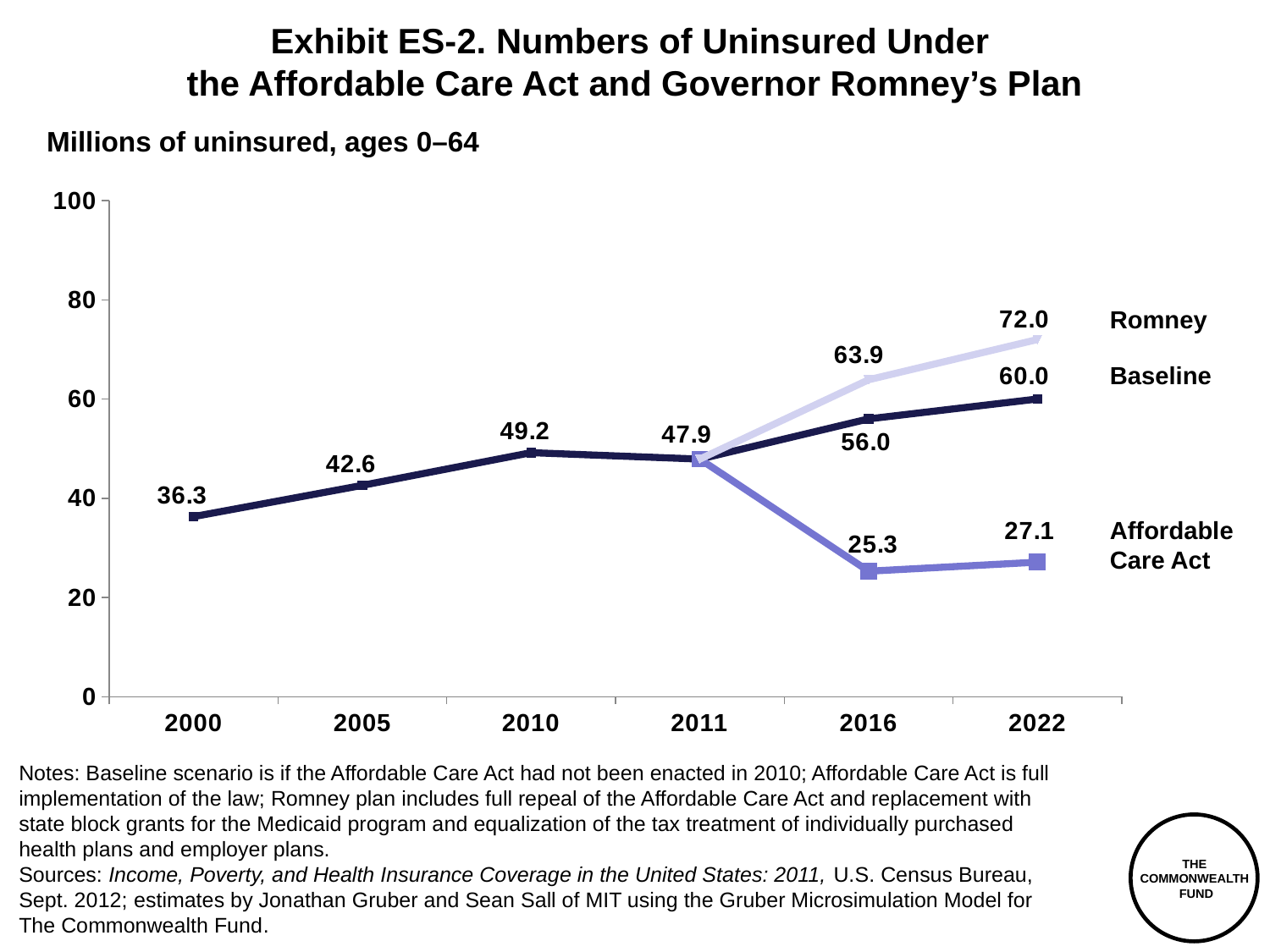
Which scenario has the highest number of uninsured in 2022? Romney Is the Affordable Care Act value for 2022 greater or less than 40? less Which is larger in 2016: the Romney value or the Baseline value? Romney What is the difference between the Romney and Affordable Care Act values in 2022? 44.9 What kind of chart is shown on the slide? line chart What is the Baseline value for 2022? 60.0 What is the number of uninsured (millions) in 2000? 36.3 What is the difference between the Baseline value in 2016 and the Affordable Care Act value in 2016? 30.7 How many years are shown on the x axis? 6 What is the projected number of uninsured under the Romney plan in 2022? 72.0 What is the projected number of uninsured under the Affordable Care Act in 2016? 25.3 Which scenario has the lowest number of uninsured in 2016? Affordable Care Act